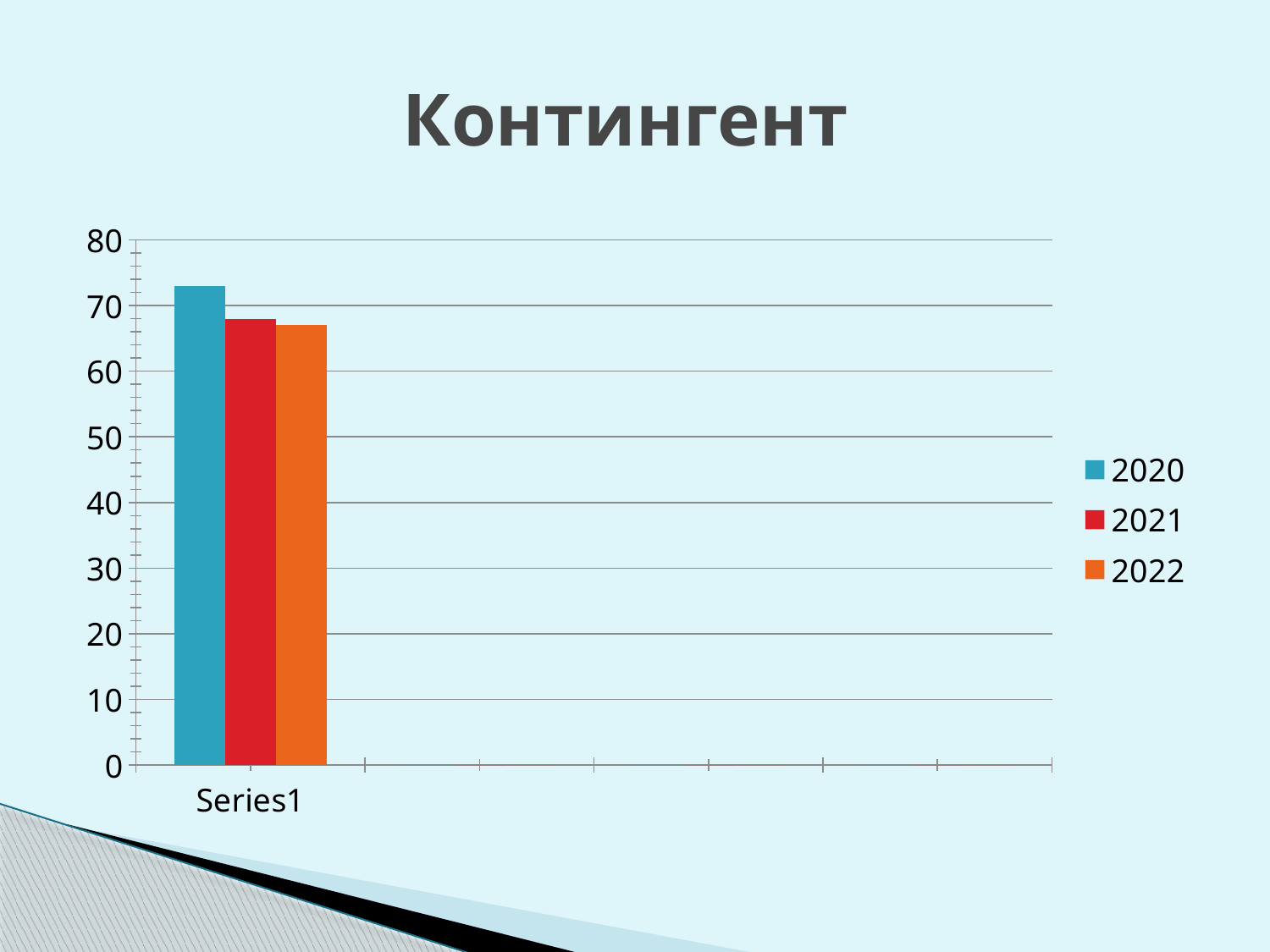
Which series has the highest bar? 2020 What kind of chart is shown on the slide? bar chart How many categories are shown on the x axis? 1 Which is larger, the value for 2020 or the value for 2021? 2020 Which years are listed in the legend? 2020, 2021, 2022 Is the value for 2020 greater or less than 70? greater Which is larger, the value for 2020 or the value for 2022? 2020 Is the value for 2022 greater or less than 70? less How many series does the legend list? 3 Do the values rise or fall from 2020 to 2022? fall Is the value for 2021 greater or less than 70? less What is the title of the chart? Контингент